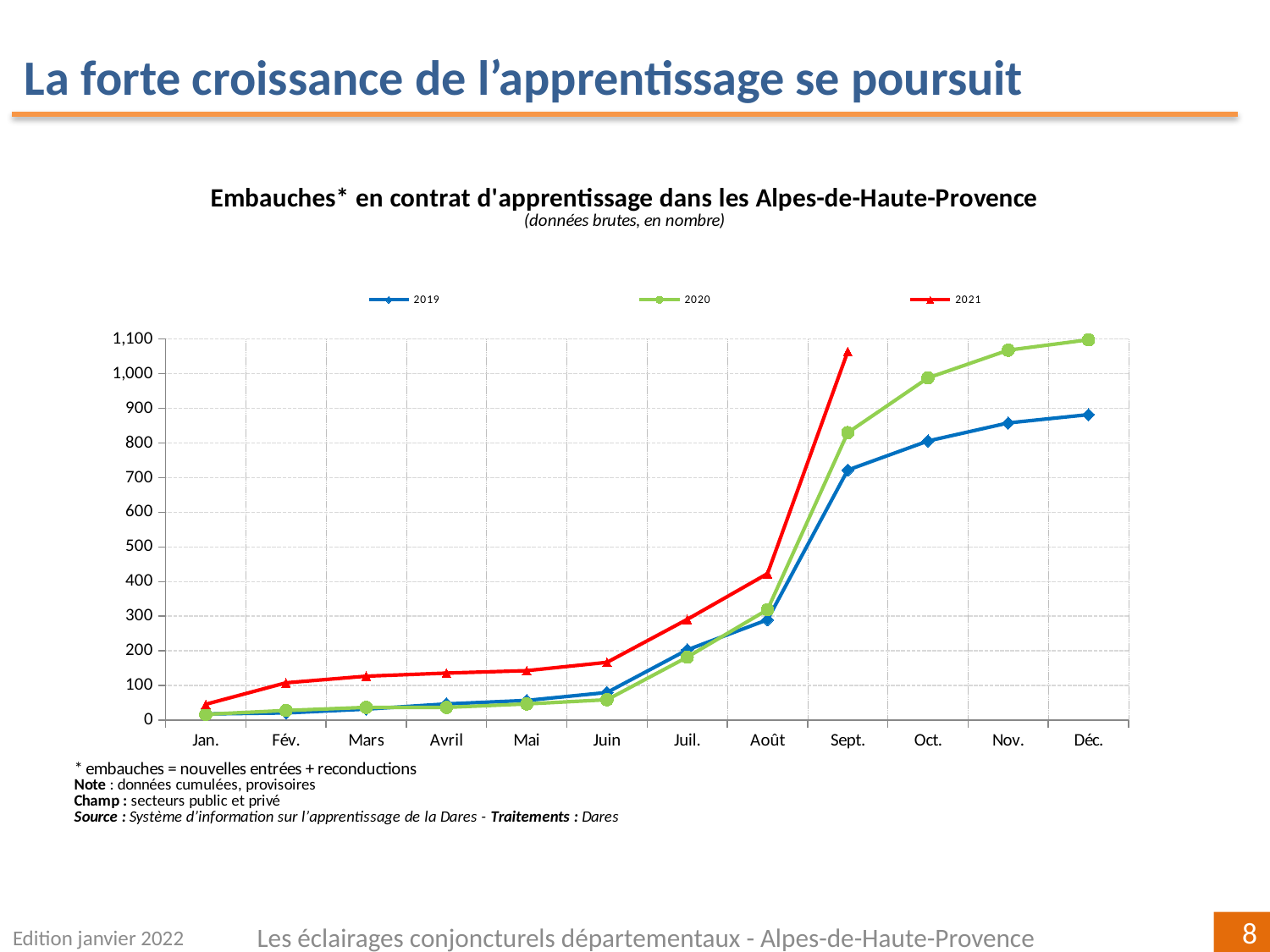
Which series has the higher value in Août, 2020 or 2021? 2021 Which series has the highest value in Sept.? 2021 Is the value for 2019 in Juin greater or less than 100? less What kind of chart is shown on the slide? line chart Which series is drawn in red? 2021 Is the value for 2019 in Déc. greater or less than 800? greater How many series does the legend list? 3 Is the value for 2021 in Sept. greater or less than 1,000? greater How many months are shown on the x axis? 12 Do the values for the 2020 series rise or fall from Jan. to Déc.? rise